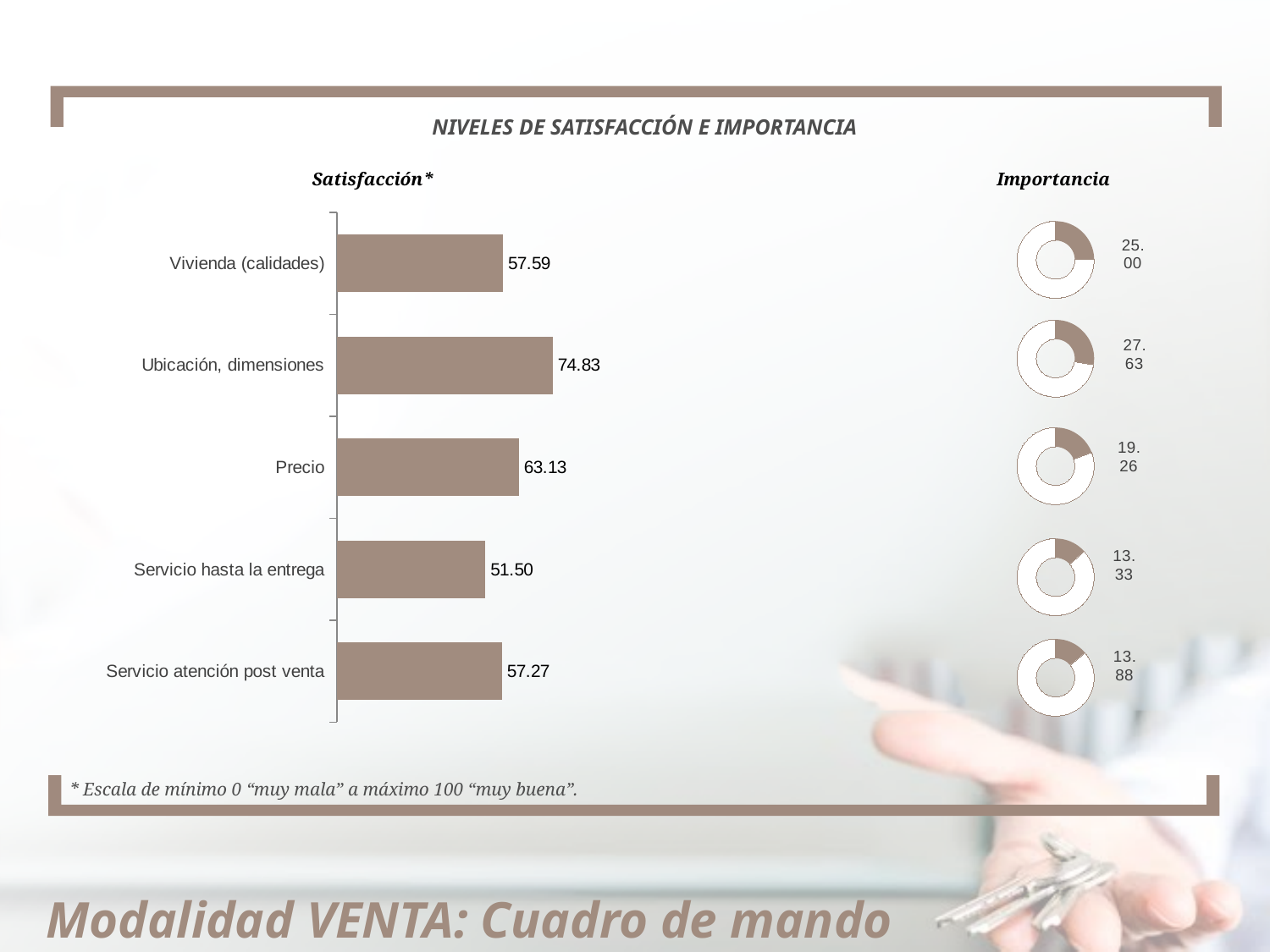
In the Importancia donut charts, what is the value shown for Servicio hasta la entrega? 13.33 In the Satisfacción bar chart, what is the difference between Ubicación, dimensiones and Servicio hasta la entrega? 23.33 In the Satisfacción bar chart, what is the value for Servicio hasta la entrega? 51.50 What kind of chart is the Satisfacción chart? Bar chart In the Satisfacción bar chart, which is larger: Precio or Servicio atención post venta? Precio In the Satisfacción bar chart, what is the value for Precio? 63.13 How many categories does the Satisfacción bar chart show? 5 In the Importancia donut charts, what is the value shown for Ubicación, dimensiones? 27.63 In the Satisfacción bar chart, which category has the lowest value? Servicio hasta la entrega In the Satisfacción bar chart, what is the difference between Precio and Vivienda (calidades)? 5.54 In the Satisfacción bar chart, which category has the highest value? Ubicación, dimensiones In the Satisfacción bar chart, what is the value for Ubicación, dimensiones? 74.83